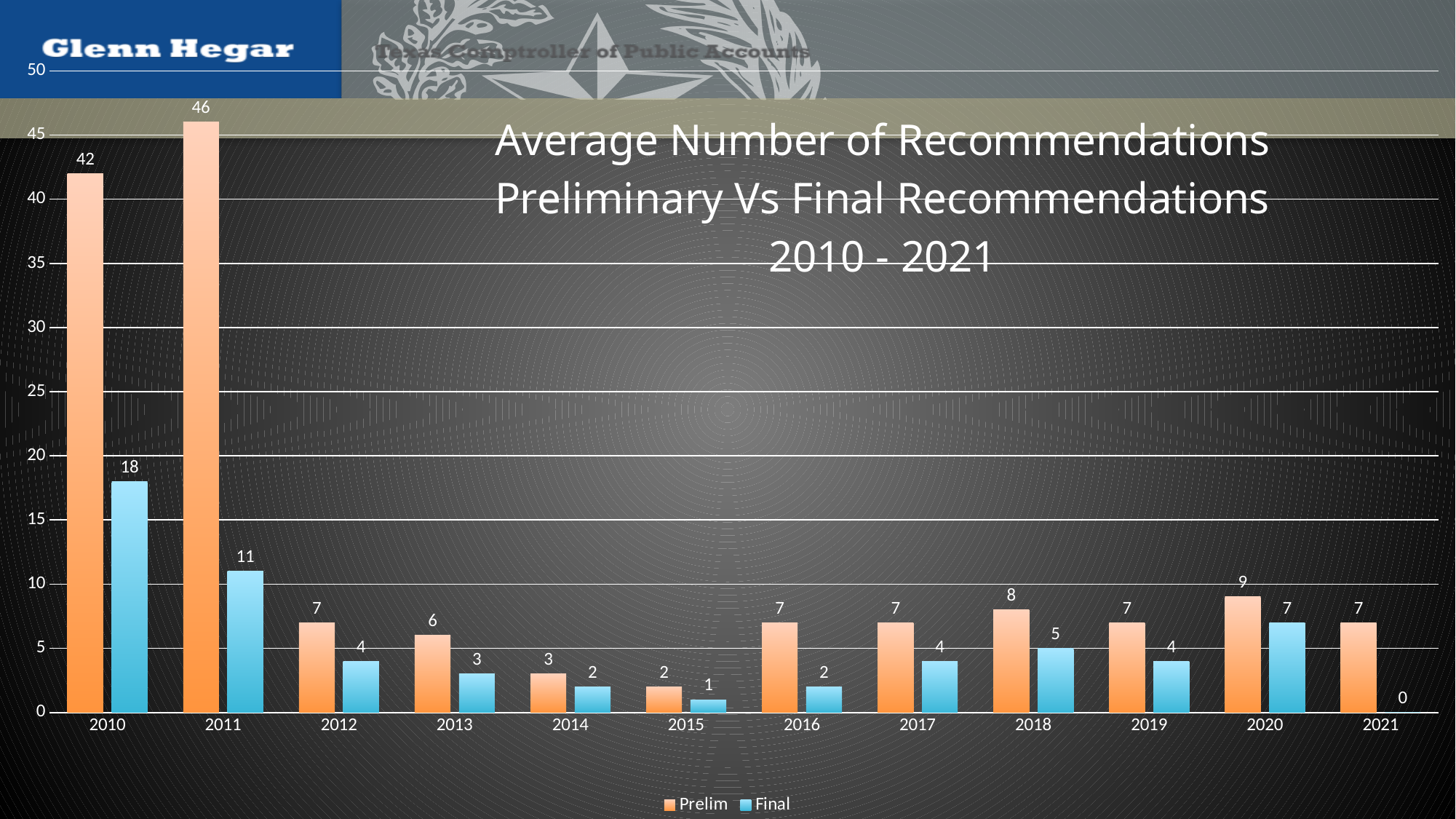
What is the Prelim value for 2011? 46 What are the two series listed in the legend? Prelim and Final Which year has the lowest Final value? 2021 Which year has the highest Prelim value? 2011 How many series does the legend list? 2 How many years are shown on the x axis? 12 What is the Final value for 2010? 18 What is the Prelim value for 2015? 2 Which is larger, the Prelim value for 2020 or the Prelim value for 2019? Prelim value for 2020 What kind of chart is shown on the slide? Bar chart What is the Final value for 2021? 0 What is the difference between the Prelim and Final values for 2010? 24